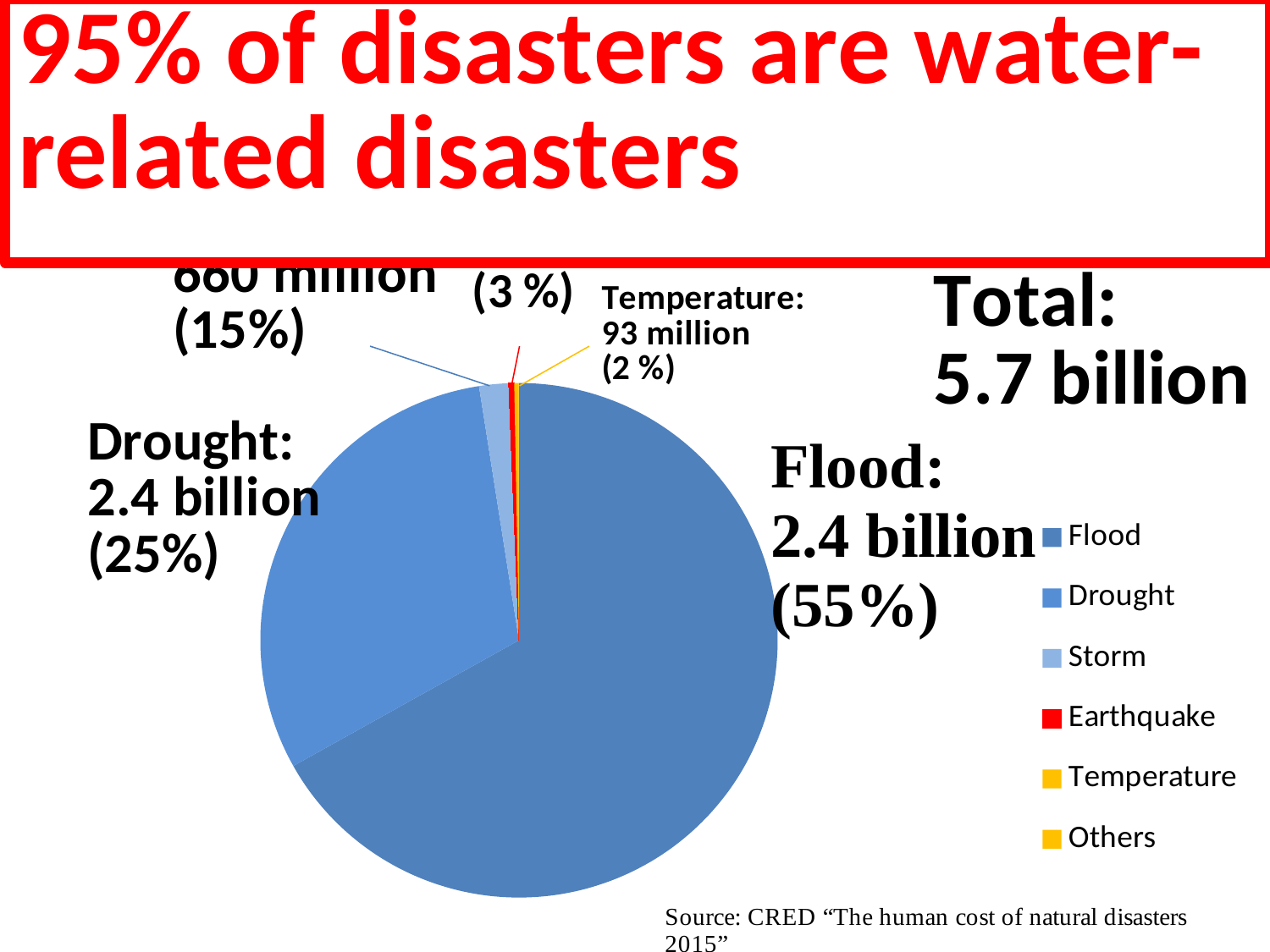
Which has a larger share of the pie, Flood or Drought? Flood What is the value shown for Drought? 2.4 billion How many categories does the legend of the pie chart list? 6 What share of the pie does Flood account for? 55% By how many percentage points does Flood's share exceed Drought's share? 30 What is the value shown for Temperature? 93 million What percentage of the pie is Drought? 25% What colour represents Earthquake in the legend? red What kind of chart is shown on the slide? pie chart What share of the pie does Temperature account for? 2 % What total is stated on the slide for the pie chart? 5.7 billion Which category has the largest slice of the pie? Flood